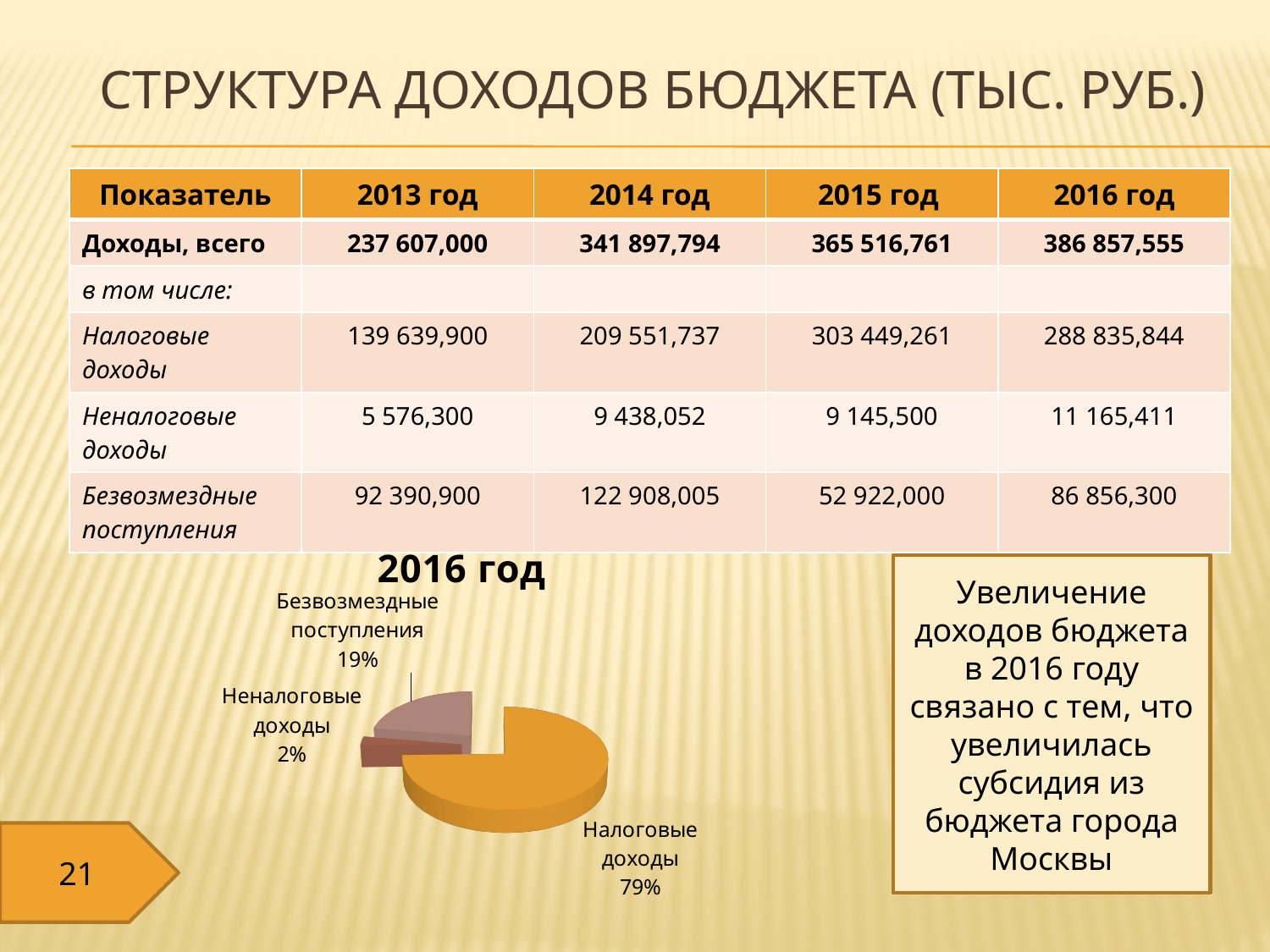
How many slices does the pie chart have? 3 What is the difference in percentage points between the Налоговые доходы slice and the Безвозмездные поступления slice? 60 What is the difference in percentage points between the Безвозмездные поступления slice and the Неналоговые доходы slice? 17 What is the title of the pie chart? 2016 год Which is larger in the pie chart, Безвозмездные поступления or Неналоговые доходы? Безвозмездные поступления What kind of chart is shown on the slide? pie chart What share of the pie chart does Налоговые доходы have? 79% What colour is the Налоговые доходы slice in the pie chart? orange What share of the pie chart does Неналоговые доходы have? 2% Which category has the smallest slice in the pie chart? Неналоговые доходы Which category has the largest slice in the pie chart? Налоговые доходы What share of the pie chart does Безвозмездные поступления have? 19%